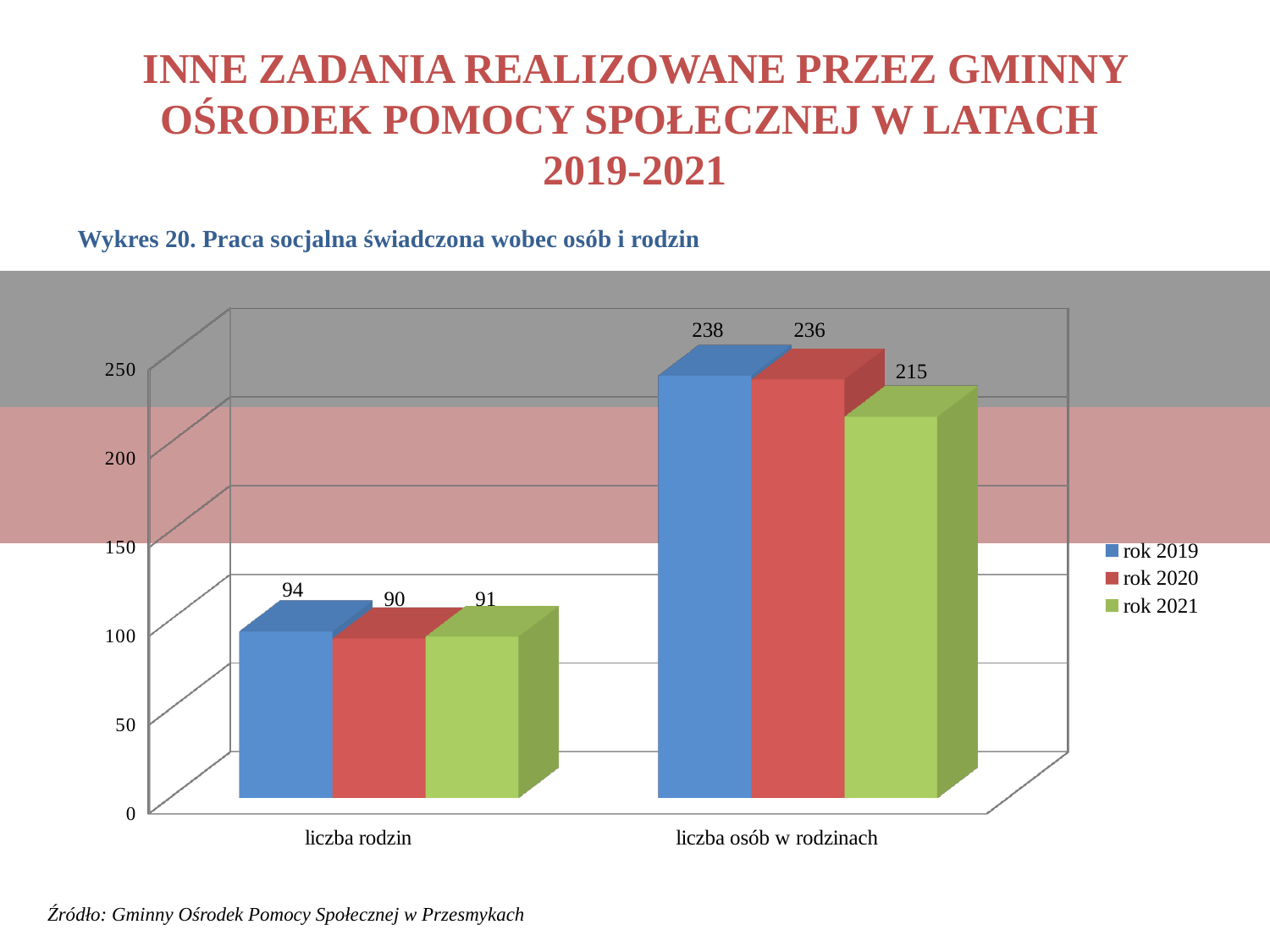
Which is larger: the 'rok 2021' value for 'liczba rodzin' or the 'rok 2020' value for 'liczba rodzin'? rok 2021 Which year has the lowest value for 'liczba rodzin'? rok 2020 What kind of chart is shown on the slide? bar chart Which year has the highest value for 'liczba osób w rodzinach'? rok 2019 What is the difference between the 'rok 2019' and 'rok 2021' values for 'liczba osób w rodzinach'? 23 What is the title of the chart (Wykres 20)? Praca socjalna świadczona wobec osób i rodzin What is the value for 'liczba osób w rodzinach' in the 'rok 2021' series? 215 What is the value for 'liczba rodzin' in the 'rok 2020' series? 90 What is the difference between the 'rok 2019' and 'rok 2020' values for 'liczba rodzin'? 4 How many series does the legend list? 3 How many categories are shown on the x axis? 2 What is the value for 'liczba rodzin' in the 'rok 2019' series? 94